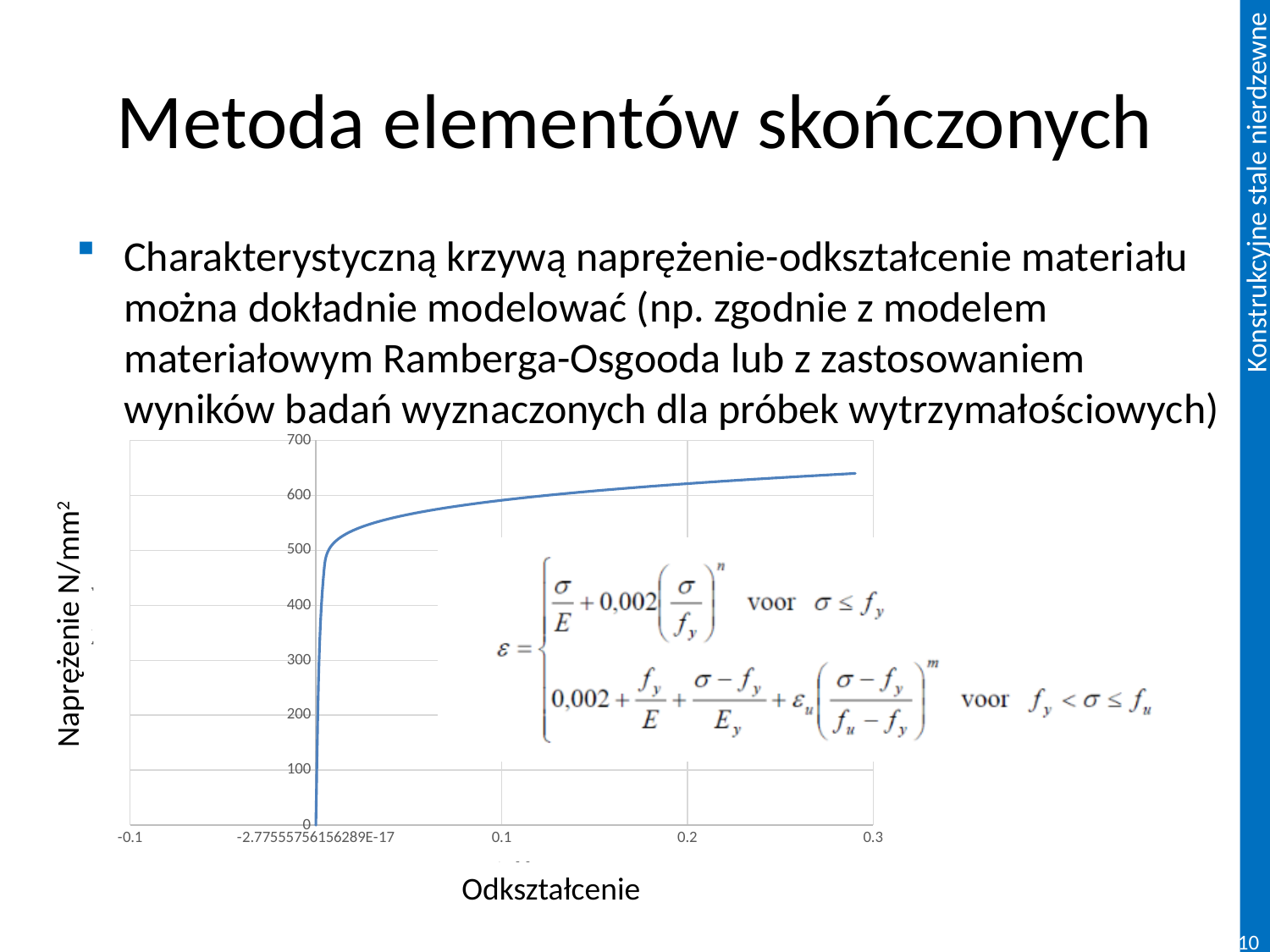
What is the label of the vertical axis of the chart? Naprężenie N/mm2 What is the label of the horizontal axis of the chart? Odkształcenie What kind of chart is shown on the slide? line chart How many data series are plotted on the chart? 1 Is the highest stress value reached by the curve greater or less than 700? less What is the highest tick value shown on the vertical axis of the chart? 700 Is the stress value at the right end of the curve (near a strain of 0.3) greater or less than 600? greater Is the stress value of the curve at a strain of 0.2 greater or less than 500? greater Does the plotted curve rise or fall as the strain (Odkształcenie) increases along the x axis? rise